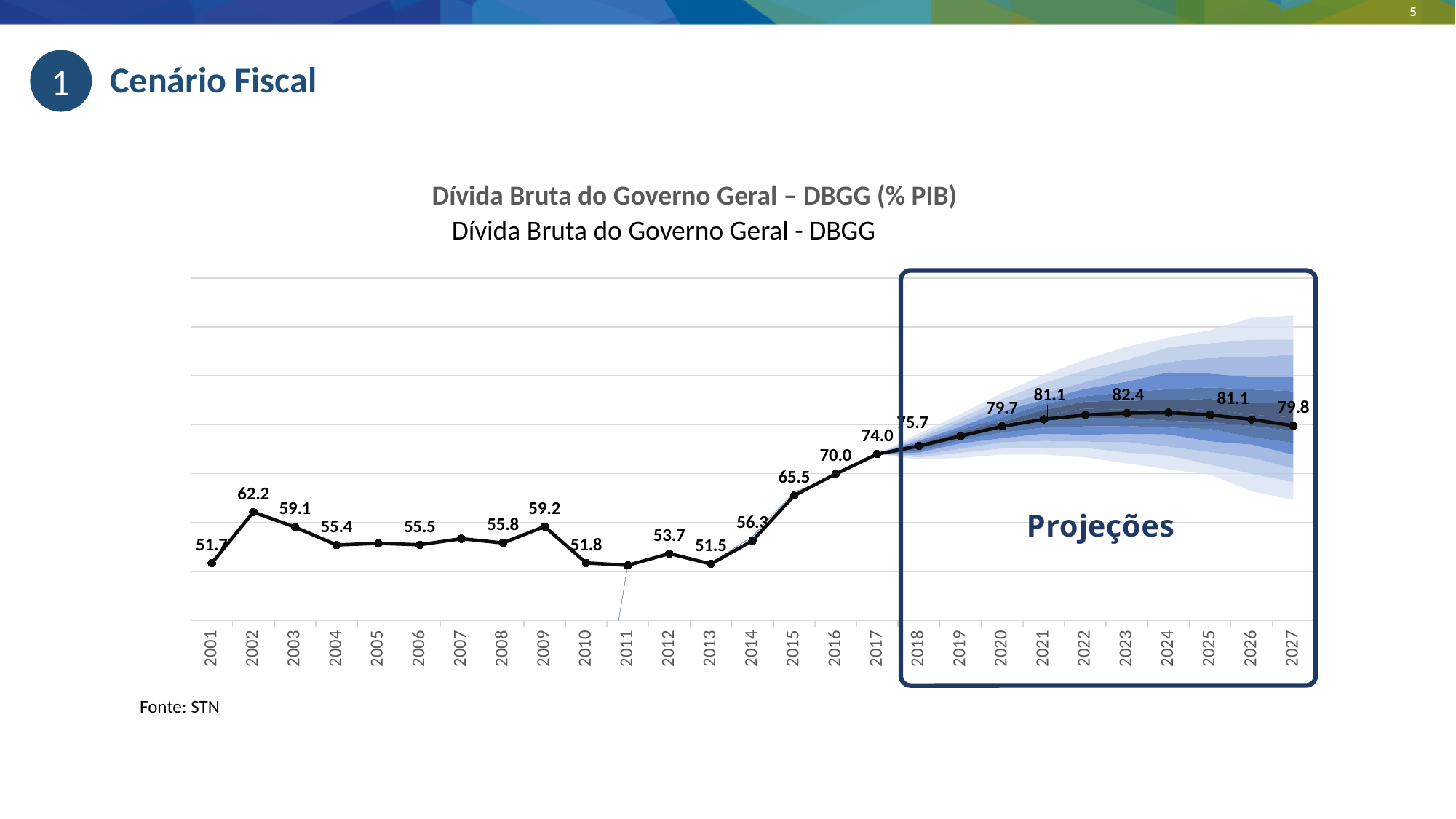
What kind of chart is shown on the slide? Line chart What is the DBGG value for 2027? 79.8 What is the DBGG value for 2017? 74.0 What is the DBGG value for 2002? 62.2 What label is shown inside the box covering the years 2018 to 2027? Projeções What is the difference between the DBGG values for 2023 and 2001? 30.7 How many years are shown on the x axis? 27 Which is larger, the DBGG value for 2009 or for 2003? 2009 What is the DBGG value for 2023? 82.4 Does the DBGG value rise or fall from 2013 to 2023? Rise